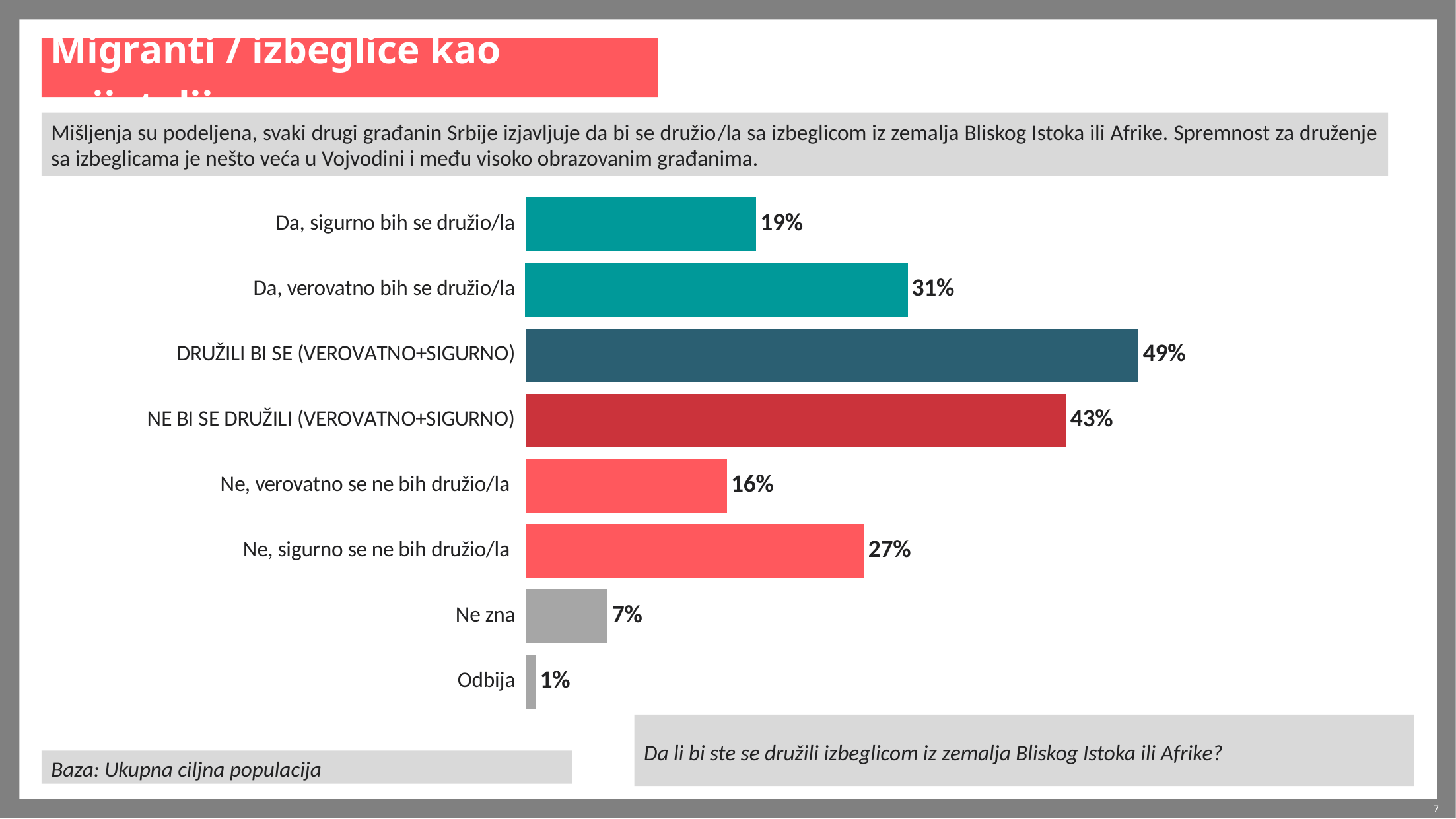
Which is larger: "Da, verovatno bih se družio/la" or "Ne, sigurno se ne bih družio/la"? Da, verovatno bih se družio/la What is the value for "Da, sigurno bih se družio/la"? 19% What is the value for "Ne, sigurno se ne bih družio/la"? 27% What is the value for "Ne zna"? 7% What is the value for "NE BI SE DRUŽILI (VEROVATNO+SIGURNO)"? 43% What kind of chart is shown on the slide? Bar chart Which category has the lowest value? Odbija How many categories are shown in the chart? 8 What is the difference between "DRUŽILI BI SE (VEROVATNO+SIGURNO)" and "NE BI SE DRUŽILI (VEROVATNO+SIGURNO)"? 6% Which category has the highest value? DRUŽILI BI SE (VEROVATNO+SIGURNO) What is the difference between "Da, verovatno bih se družio/la" and "Ne, verovatno se ne bih družio/la"? 15% What colour is the bar for "NE BI SE DRUŽILI (VEROVATNO+SIGURNO)"? Dark red